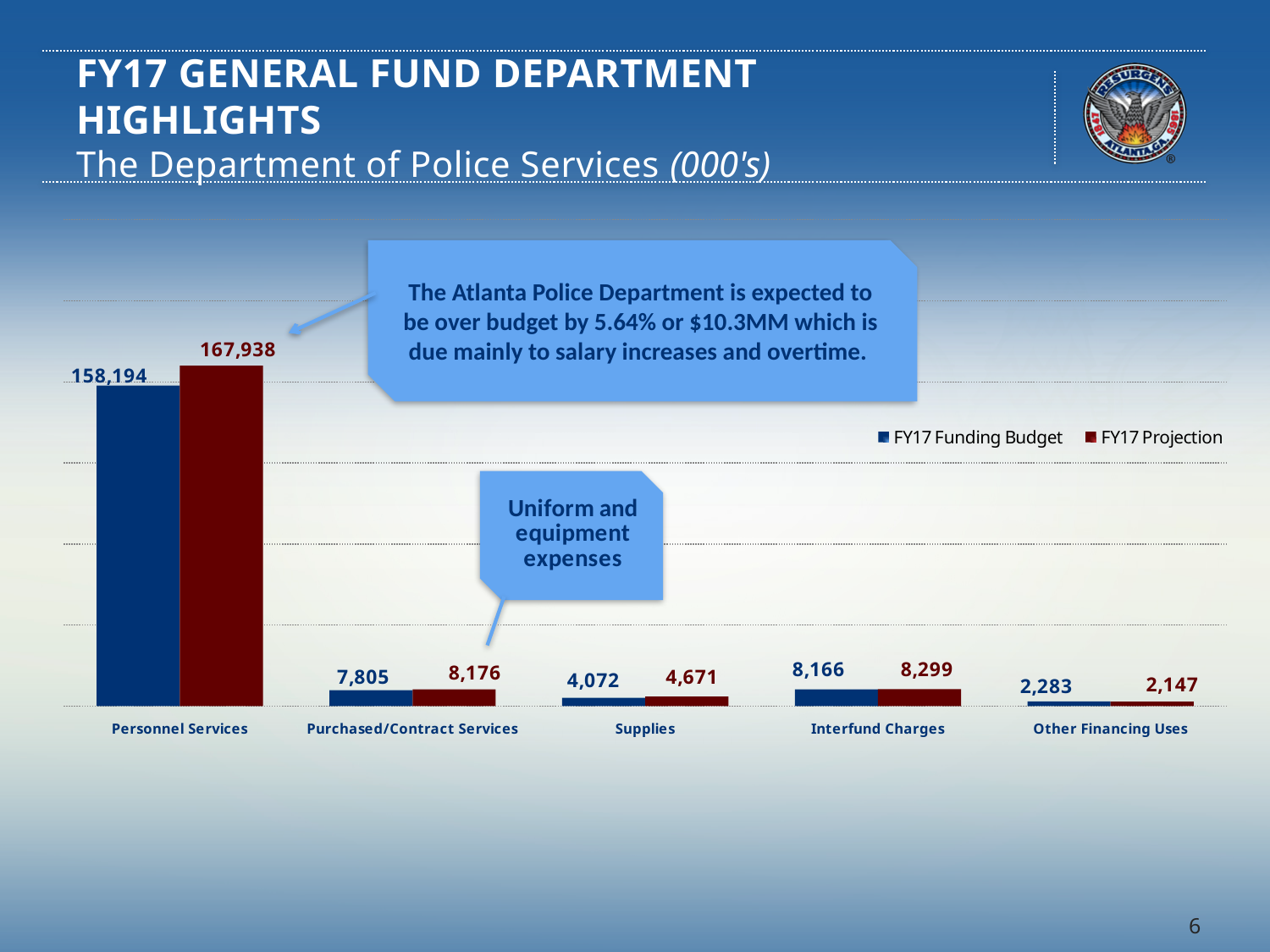
How many series does the chart legend list? 2 What is the FY17 Projection value for Supplies? 4,671 For Other Financing Uses, which is larger: the FY17 Funding Budget or the FY17 Projection? FY17 Funding Budget What is the FY17 Funding Budget value for Interfund Charges? 8,166 What is the difference between the FY17 Projection and the FY17 Funding Budget for Personnel Services? 9,744 What is the FY17 Funding Budget value for Personnel Services? 158,194 How many categories are shown on the x axis of the chart? 5 Which category has the lowest FY17 Funding Budget value? Other Financing Uses What kind of chart is shown on the slide? Bar chart What is the difference between the FY17 Projection and the FY17 Funding Budget for Purchased/Contract Services? 371 What is the FY17 Projection value for Other Financing Uses? 2,147 Which category has the highest FY17 Projection value? Personnel Services